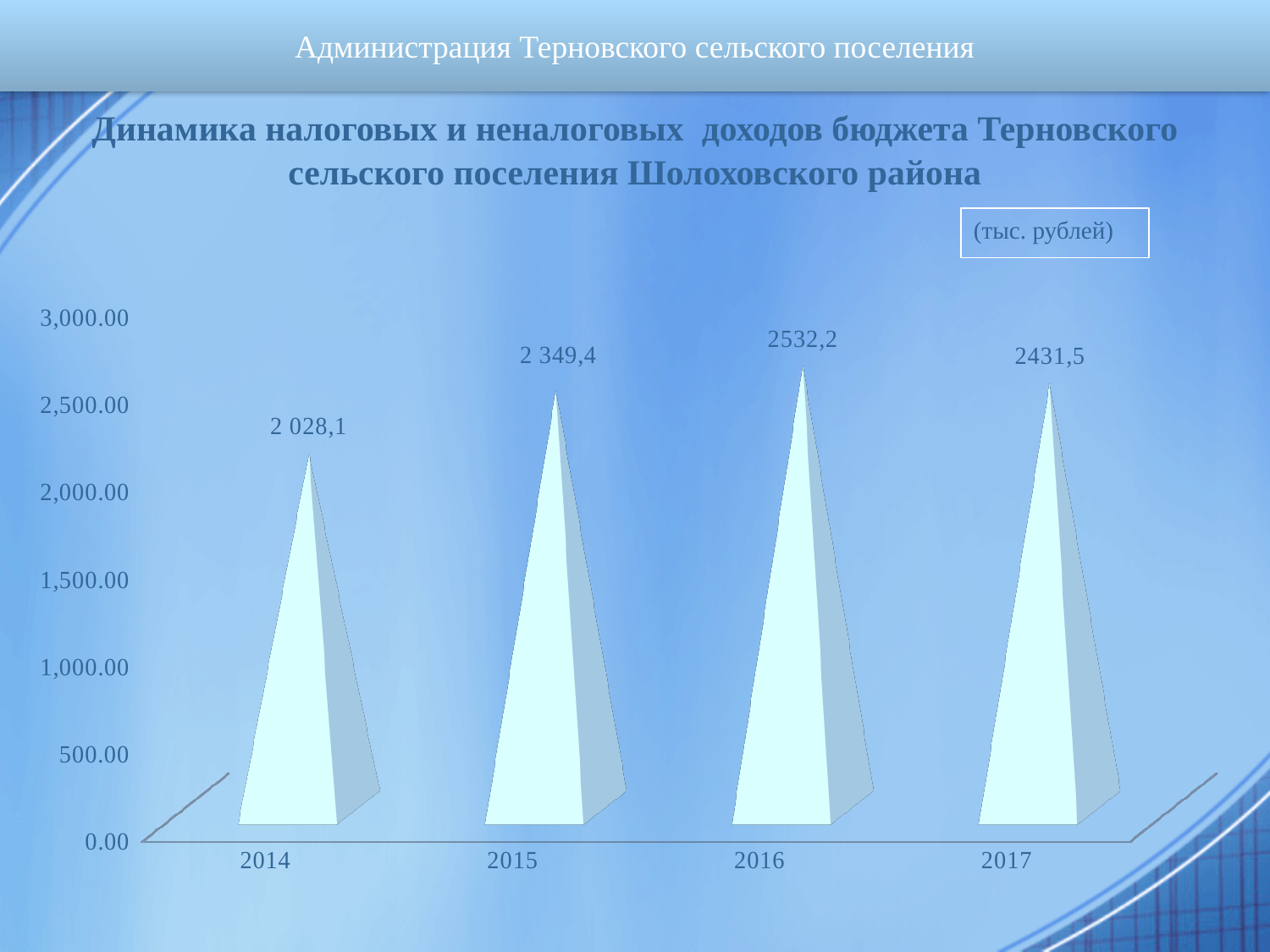
What is the value shown for 2017? 2431,5 What is the value shown for 2016? 2532,2 What is the value shown for 2014? 2 028,1 How many years are shown on the x axis? 4 Is the value for 2015 greater or less than 2,500.00? less Which year has the highest value? 2016 Which year has the lowest value? 2014 What is the value shown for 2015? 2 349,4 Which is larger, the value for 2015 or the value for 2017? 2017 By how much does the value for 2016 exceed the value for 2017? 100,7 What is the difference between the values for 2015 and 2014? 321,3 In what units are the values expressed, according to the box on the slide? тыс. рублей